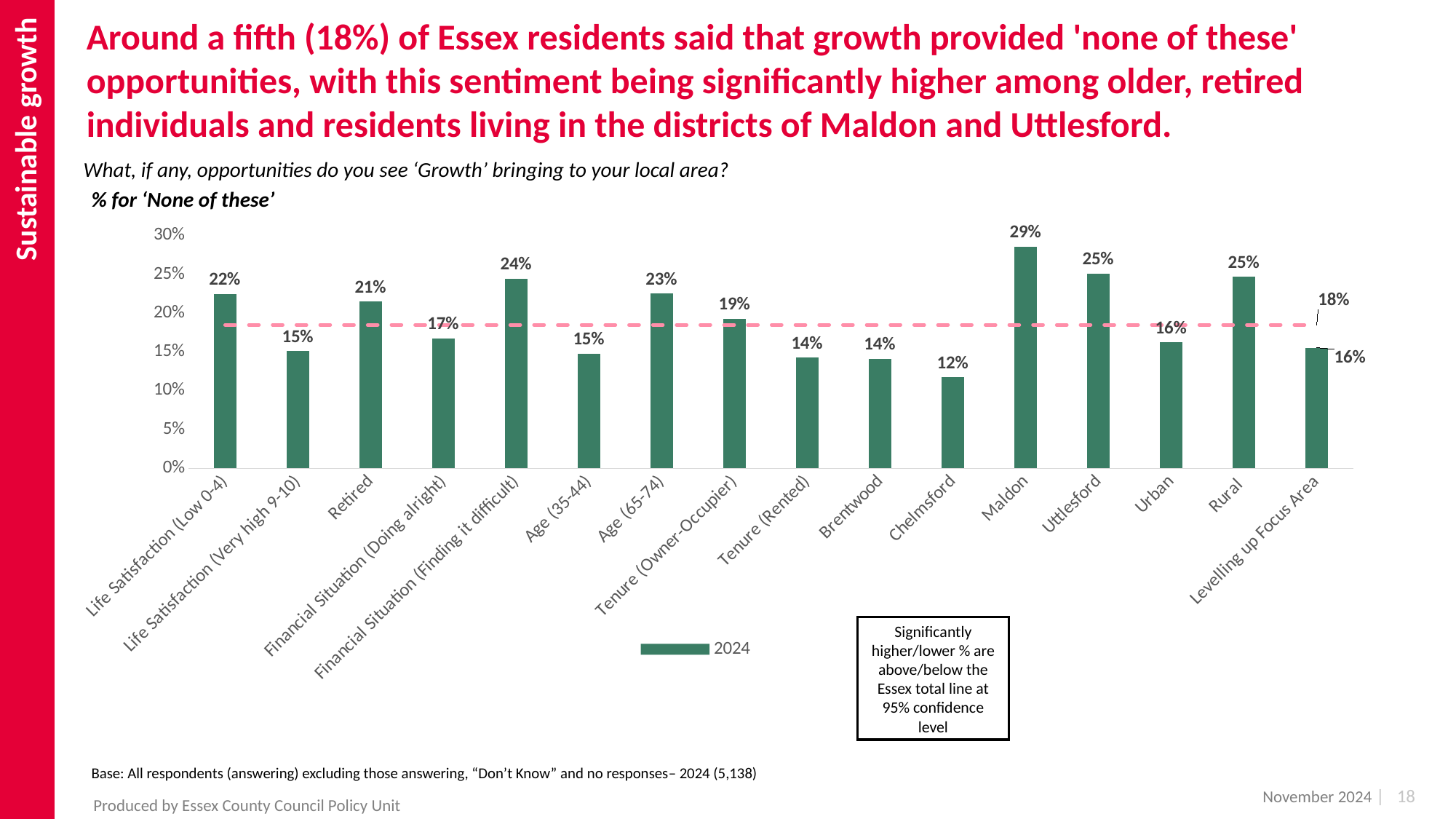
Which category has the highest value? Maldon How many series does the legend list? 1 What is the value for Financial Situation (Finding it difficult)? 24% What kind of chart is shown on the slide? Bar chart What is the value for Tenure (Owner-Occupier)? 19% What is the value for Maldon? 29% What is the difference between the values for Maldon and Chelmsford? 17% What value does the dashed horizontal line (Essex total) represent? 18% Which is larger, the value for Retired or the value for Urban? Retired Which category has the lowest value? Chelmsford How many categories are shown on the x axis? 16 What is the value for Chelmsford? 12%